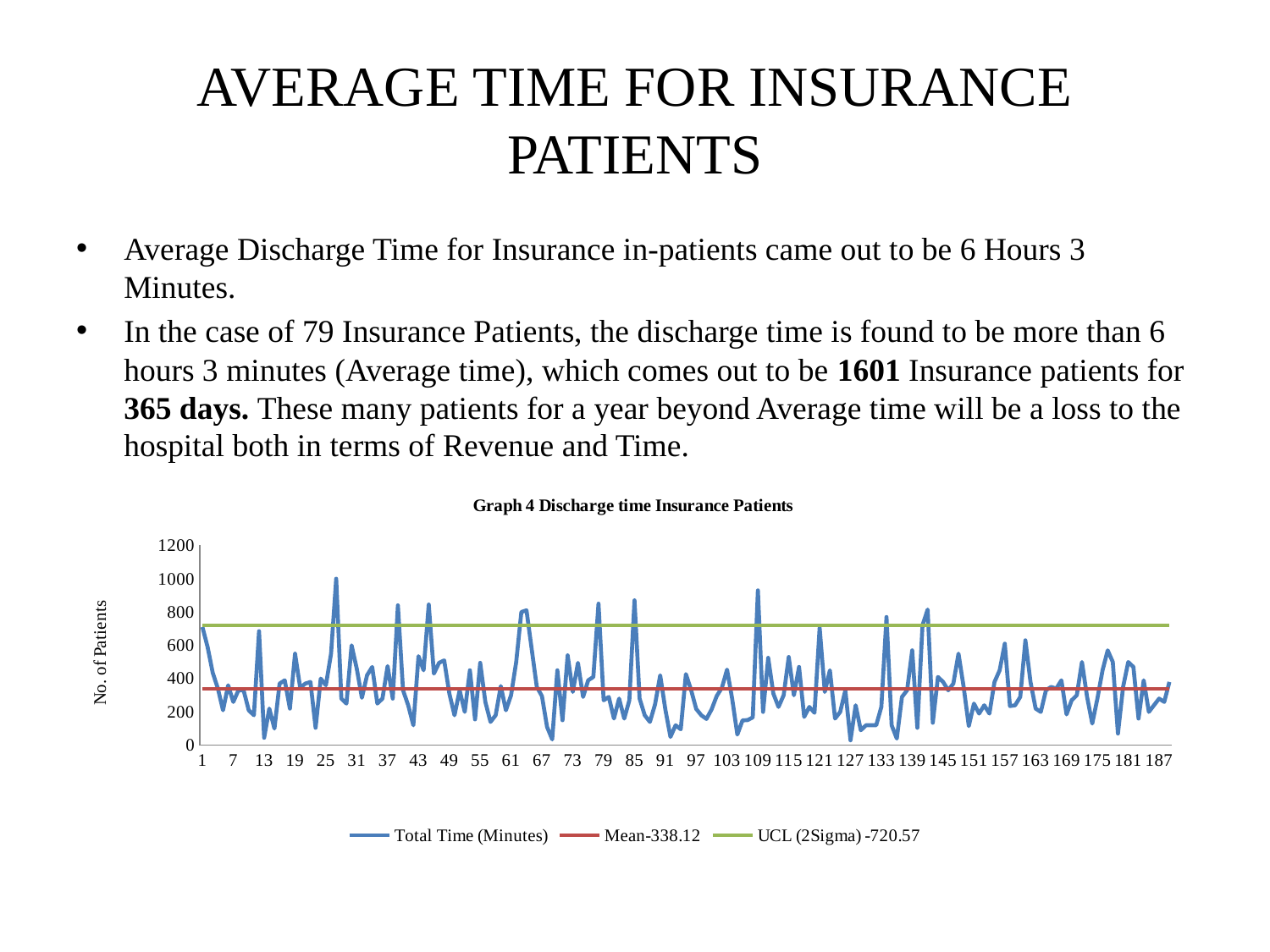
Is the Mean line greater or less than 400 on the vertical axis? less How many series does the chart legend list? 3 What value does the UCL (2Sigma) line represent, according to the legend? 720.57 Which is larger, the Mean value or the UCL (2Sigma) value? UCL (2Sigma) Is the highest value of the Total Time (Minutes) series greater or less than 800? greater What is the last label shown on the horizontal axis? 187 What kind of chart is shown on the slide? line chart What is the label on the vertical axis of the chart? No. of Patients What value does the Mean line represent, according to the legend? 338.12 What is the title of the chart? Graph 4 Discharge time Insurance Patients Is the lowest value of the Total Time (Minutes) series greater or less than 200? less What is the difference between the UCL (2Sigma) value and the Mean value shown in the legend? 382.45